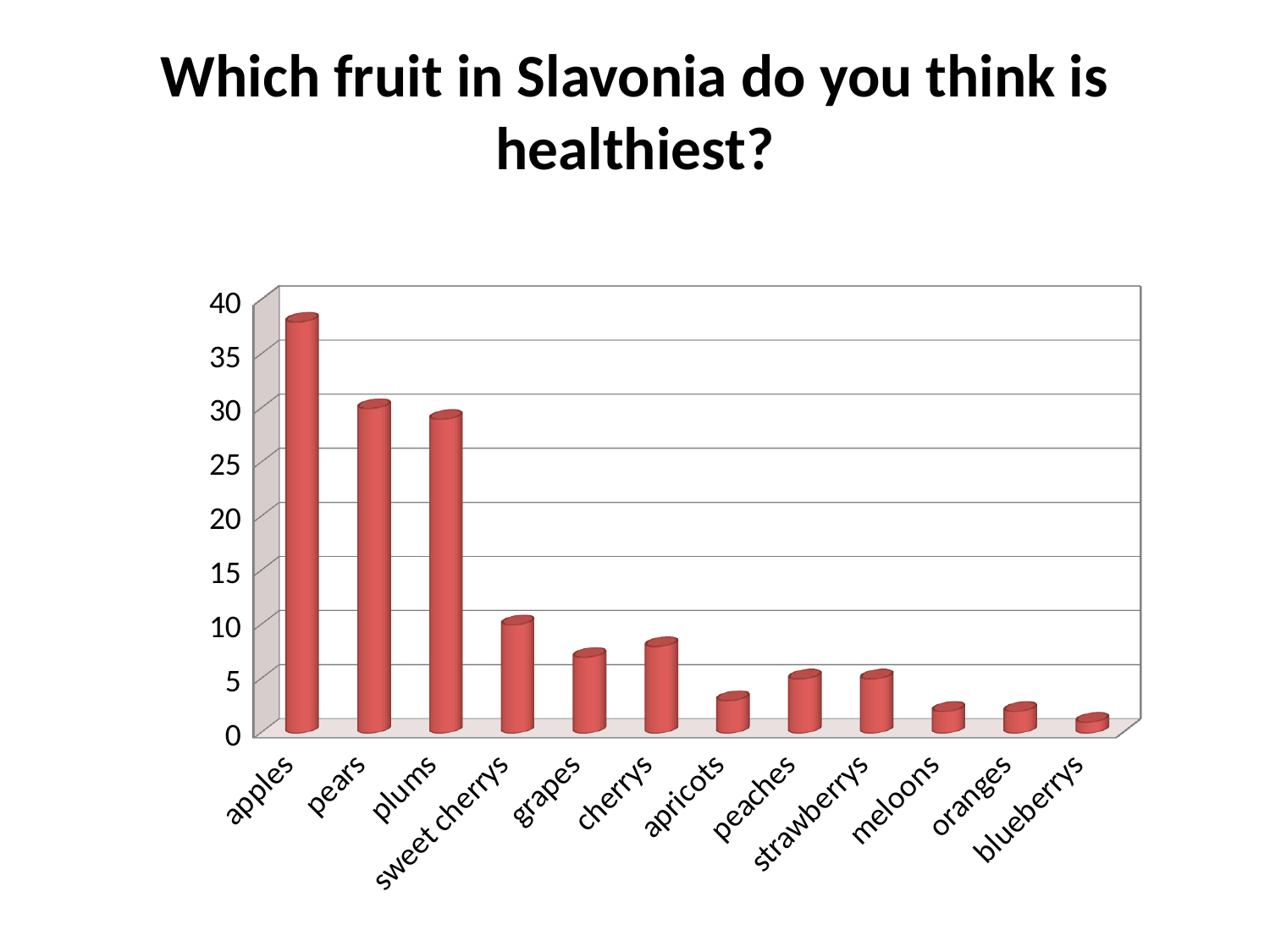
Is the value for apples greater or less than 35? greater How many fruit categories are shown on the x axis? 12 What kind of chart is shown on the slide? bar chart Is the value for meloons greater or less than 5? less Is the value for sweet cherrys greater or less than 15? less Which is larger, the value for sweet cherrys or the value for grapes? sweet cherrys Which fruit has the highest value? apples Which is larger, the value for apples or the value for pears? apples Which fruit has the lowest value? blueberrys Do the values generally rise or fall from left to right along the x axis? fall